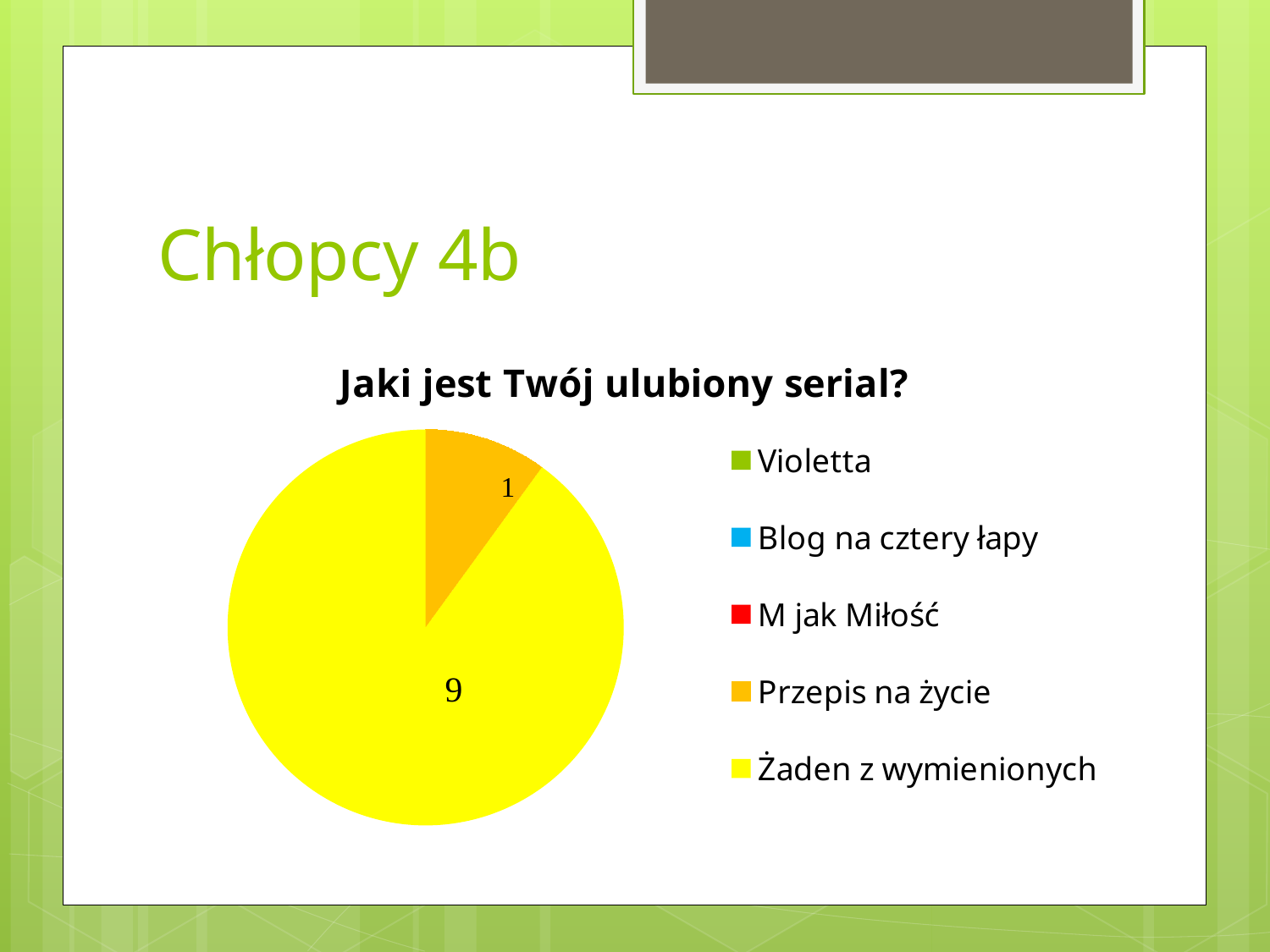
What share of the pie does Przepis na życie represent? 10% What kind of chart is shown on the slide? pie chart What colour is used for Żaden z wymienionych in the chart? yellow Which category has the largest slice of the pie? Żaden z wymienionych What is the title of the chart? Jaki jest Twój ulubiony serial? What is the value for Przepis na życie? 1 How many entries does the chart's legend list? 5 What is the total of the values shown on the pie chart? 10 What is the difference between the value for Żaden z wymienionych and the value for Przepis na życie? 8 What is the value for Żaden z wymienionych? 9 Which is larger, the value for Żaden z wymienionych or the value for Przepis na życie? Żaden z wymienionych What share of the pie does Żaden z wymienionych represent? 90%